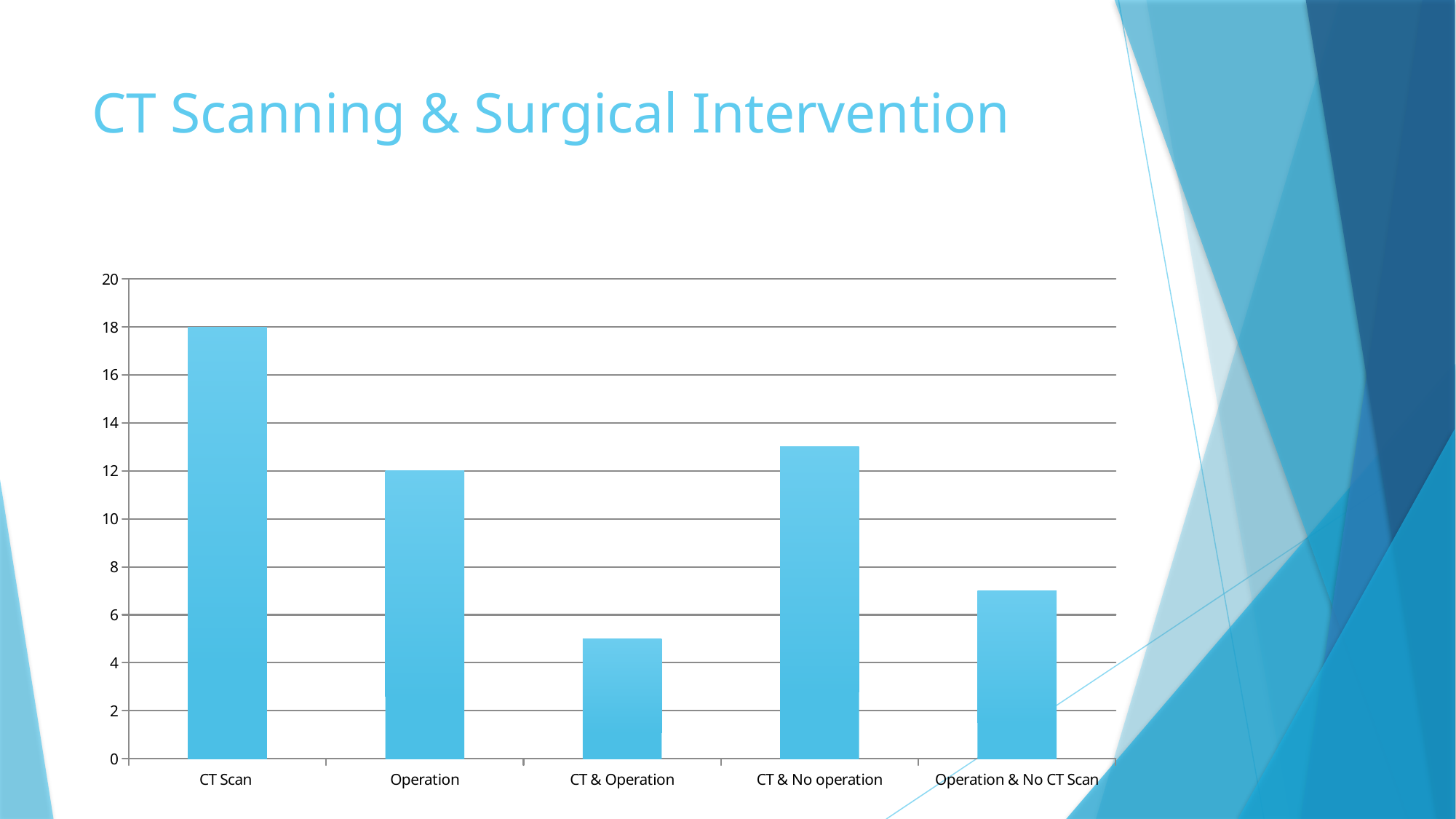
What type of chart is shown on the slide? bar chart What is the difference between the values for CT Scan and Operation? 6 Is the value for Operation & No CT Scan greater or less than 8? less Is the value for CT & No operation greater or less than 12? greater What is the title of the chart on the slide? CT Scanning & Surgical Intervention Which category has the lowest value? CT & Operation Is the value for CT & Operation greater or less than 6? less What is the value for Operation? 12 Which is larger, the value for CT & No operation or the value for Operation & No CT Scan? CT & No operation How many categories are shown on the x axis of the chart? 5 Which category has the highest value? CT Scan What is the value for CT Scan? 18